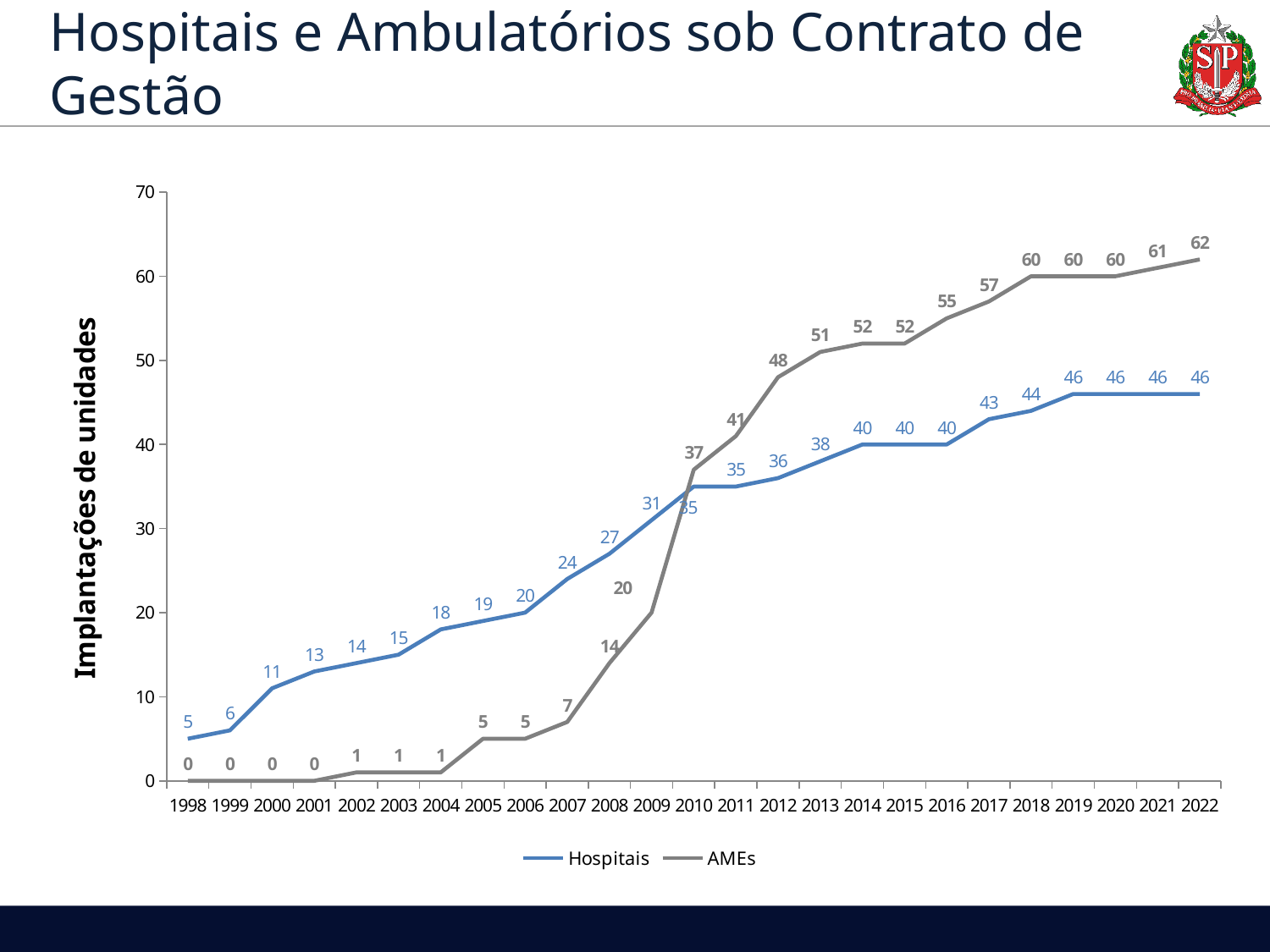
How many series does the legend list? 2 Which series has the larger value in 2009, Hospitais or AMEs? Hospitais What is the value for AMEs in 2022? 62 What is the label of the y axis? Implantações de unidades In which year is the Hospitais series at its lowest value? 1998 In which year does the AMEs series reach its highest value? 2022 What is the value for AMEs in 2012? 48 How many years are shown on the x axis? 25 What kind of chart is shown on the slide? Line chart Which series has the larger value in 2013, Hospitais or AMEs? AMEs What is the value for Hospitais in 2010? 35 What is the difference between AMEs and Hospitais in 2022? 16